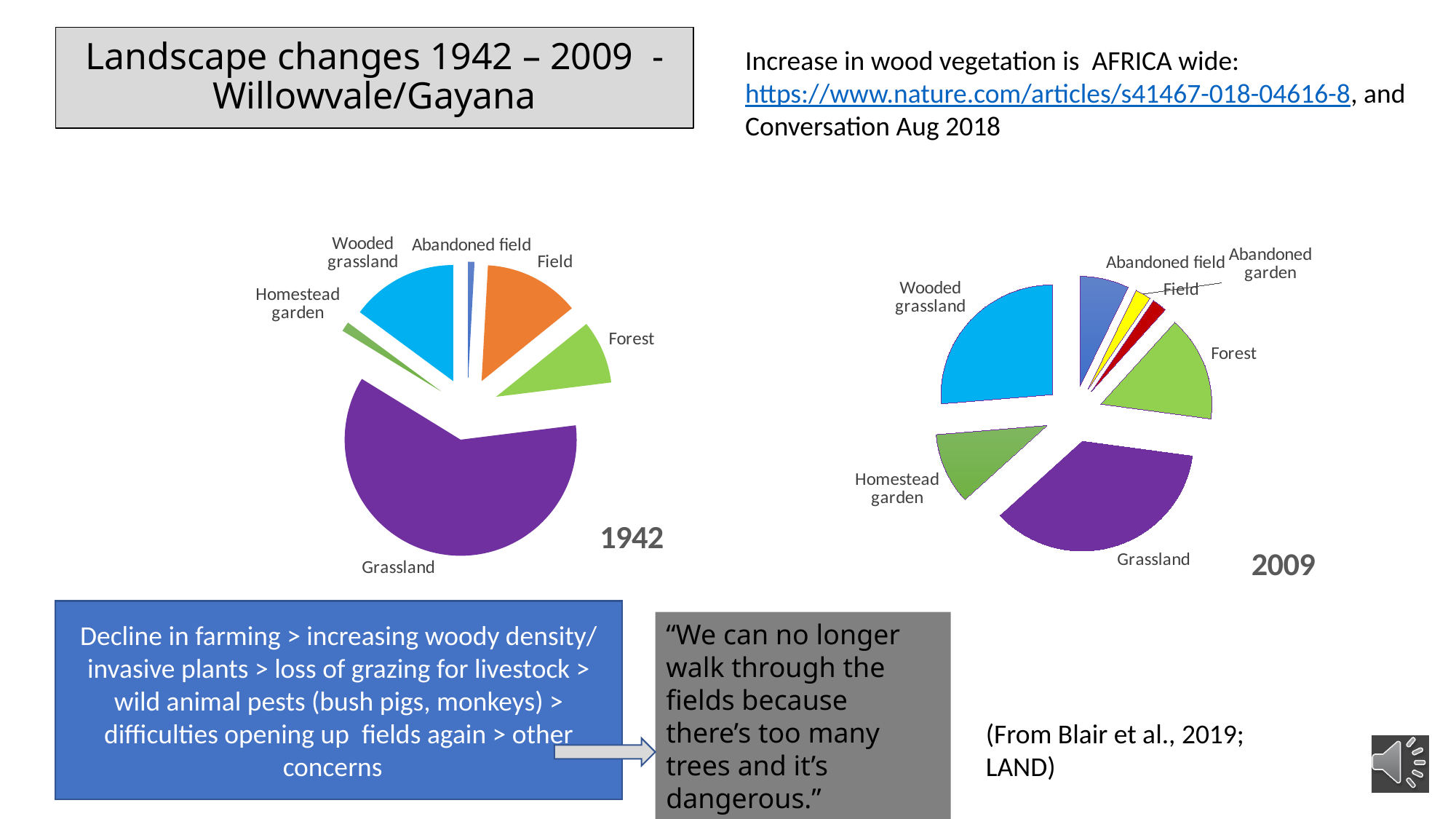
In the 2009 pie chart, which category has the largest share? Grassland In the 1942 pie chart, which is larger, Wooded grassland or Forest? Wooded grassland In the 2009 pie chart, which is larger, Forest or Field? Forest What kind of chart is the 1942 chart? pie chart In the 2009 pie chart, which is larger, Wooded grassland or Forest? Wooded grassland How many categories does the 1942 pie chart show? 6 What colour is the Grassland slice in the 1942 pie chart? purple In the 1942 pie chart, which category has the largest share? Grassland Which category appears in the 2009 pie chart but not in the 1942 pie chart? Abandoned garden How many categories does the 2009 pie chart show? 7